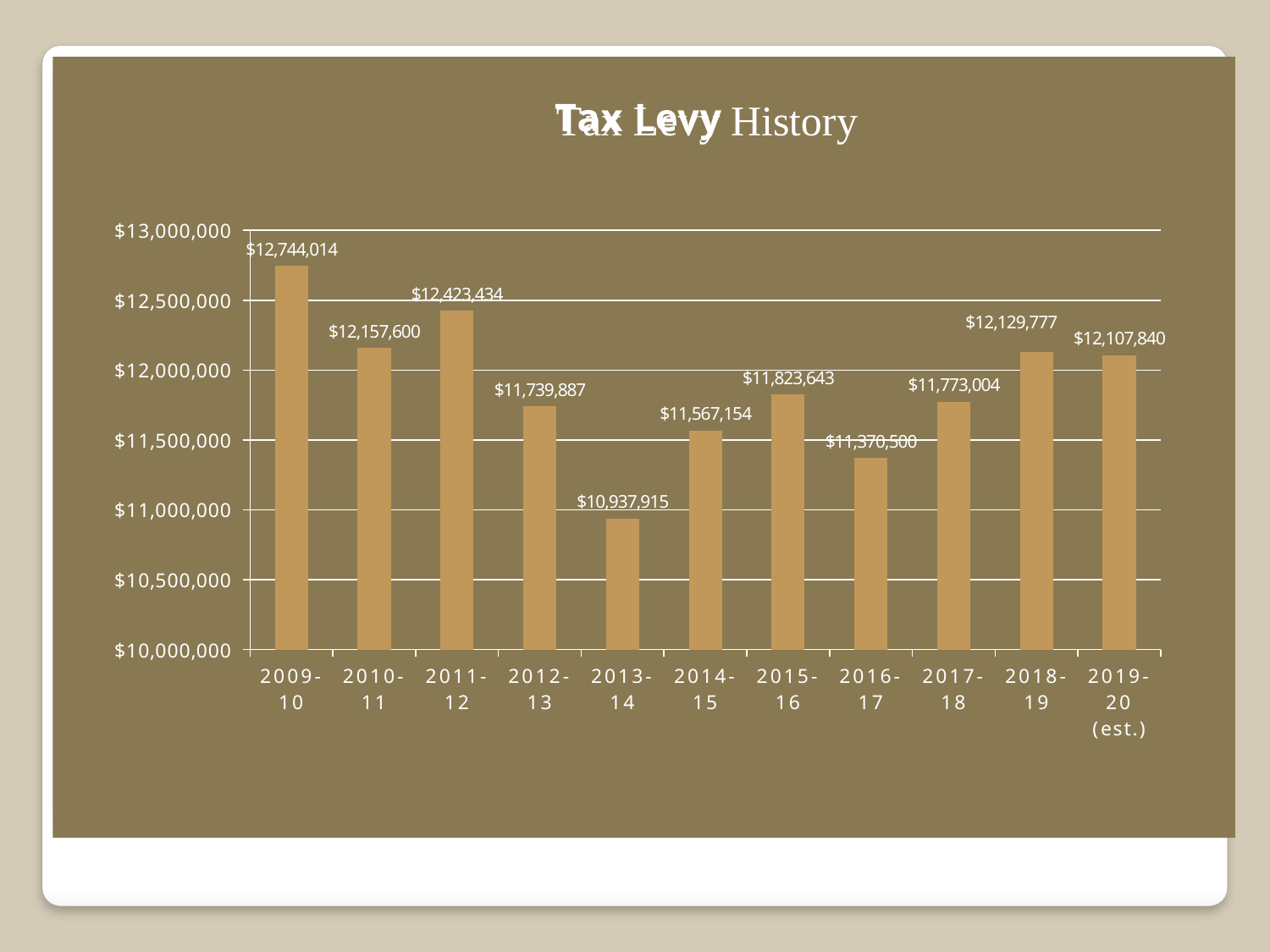
What is the estimated tax levy for 2019-20? $12,107,840 What is the difference between the tax levy in 2015-16 and in 2014-15? $256,489 Which year has the lowest tax levy? 2013-14 What is the difference between the tax levy in 2009-10 and in 2013-14? $1,806,099 What is the title of the chart? Tax Levy History What kind of chart is shown on the slide? Bar chart Which is larger, the tax levy for 2010-11 or for 2011-12? 2011-12 What is the tax levy for 2013-14? $10,937,915 How many years are shown on the chart? 11 What is the tax levy for 2009-10? $12,744,014 Is the tax levy for 2016-17 greater or less than $11,500,000? less Which year has the highest tax levy? 2009-10